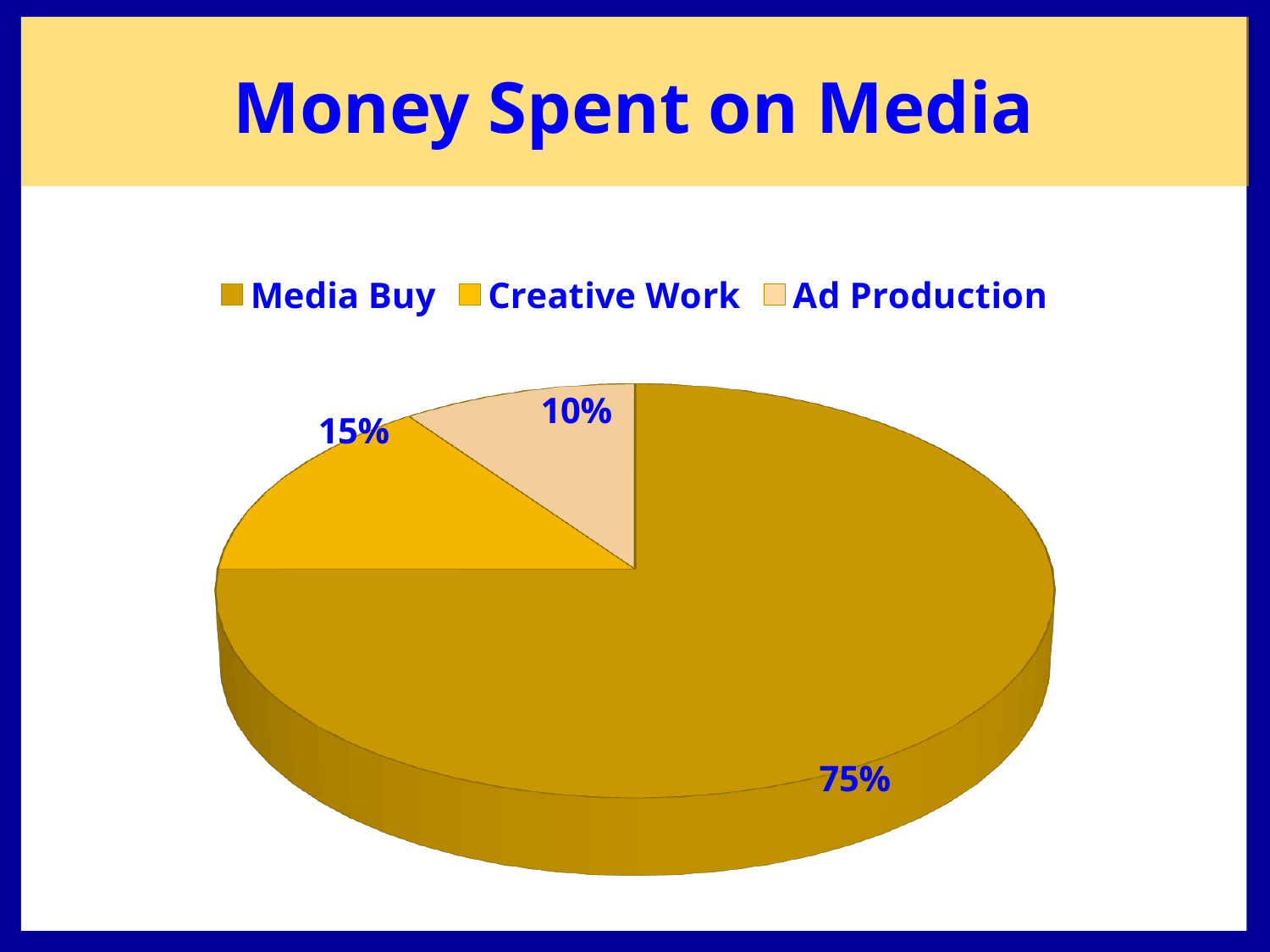
What kind of chart is shown on the slide? Pie chart What is the title of the chart? Money Spent on Media What is the difference in percentage points between Creative Work and Ad Production? 5 Which is larger, the Creative Work slice or the Ad Production slice? Creative Work What share of the pie does Creative Work account for? 15% Which category is listed first in the legend? Media Buy Which category has the smallest slice of the pie? Ad Production Which category has the largest slice of the pie? Media Buy What share of the pie does Ad Production account for? 10% What share of the pie does Media Buy account for? 75% How many categories are shown in the pie chart? 3 What is the difference in percentage points between Media Buy and Creative Work? 60